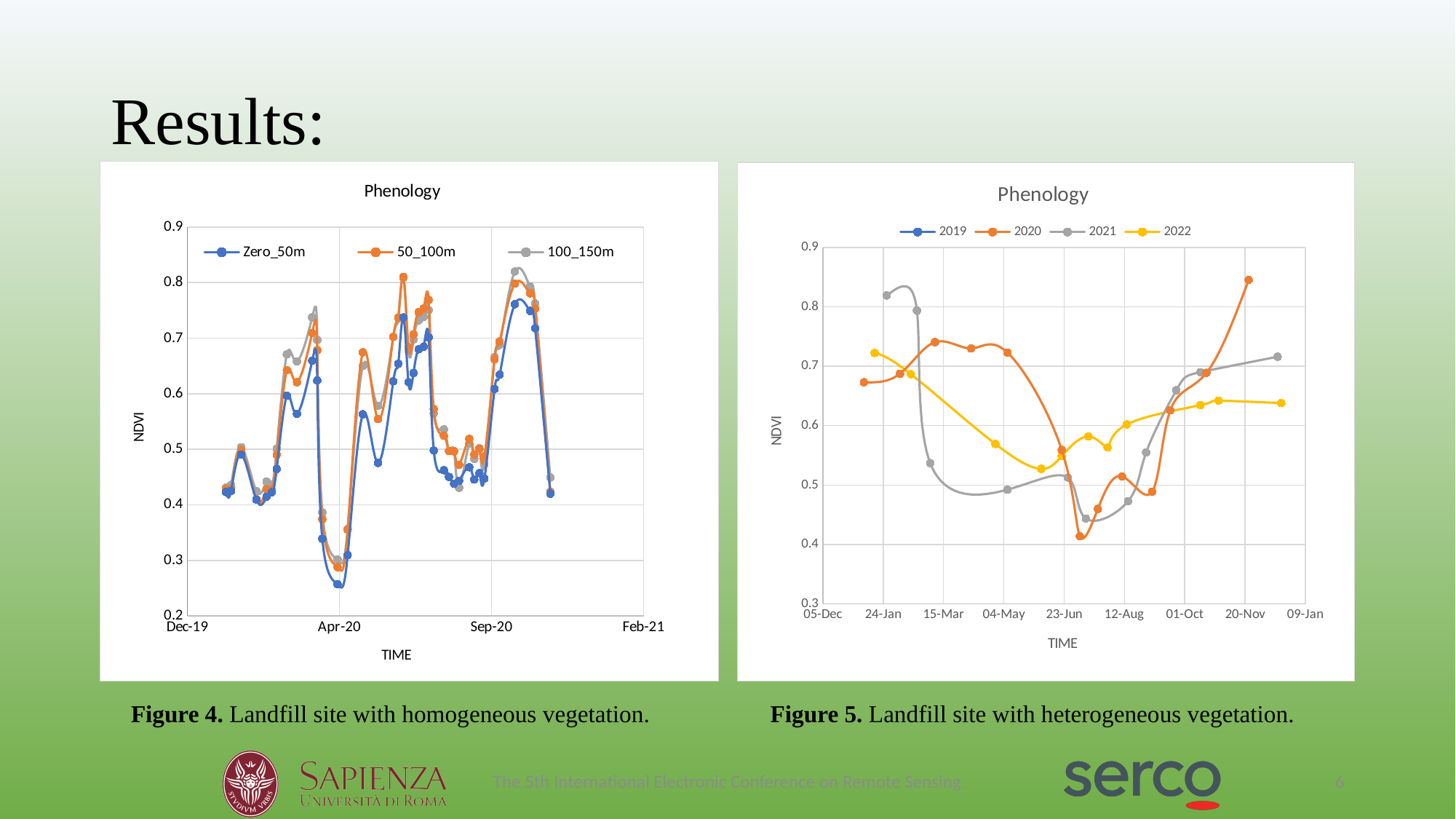
In the right chart (Figure 5), is the lowest value of the 2020 series greater or less than 0.5? less How many series does the legend of the right chart (Figure 5) list? 4 In the left chart (Figure 4), is the highest value of the 100_150m series greater or less than 0.8? greater In the left chart (Figure 4), which series reaches the lowest NDVI value? Zero_50m In the right chart (Figure 5), which series has the larger value around 20-Nov: 2020 or 2021? 2020 What type of chart is shown in Figure 4 (left chart)? Line chart In the left chart (Figure 4), is the lowest value of the Zero_50m series greater or less than 0.3? less In the right chart (Figure 5), does the 2022 series rise or fall between 24-Jan and 23-Jun? Fall What is the y-axis label of the left chart (Figure 4)? NDVI How many series does the legend of the left chart (Figure 4) list? 3